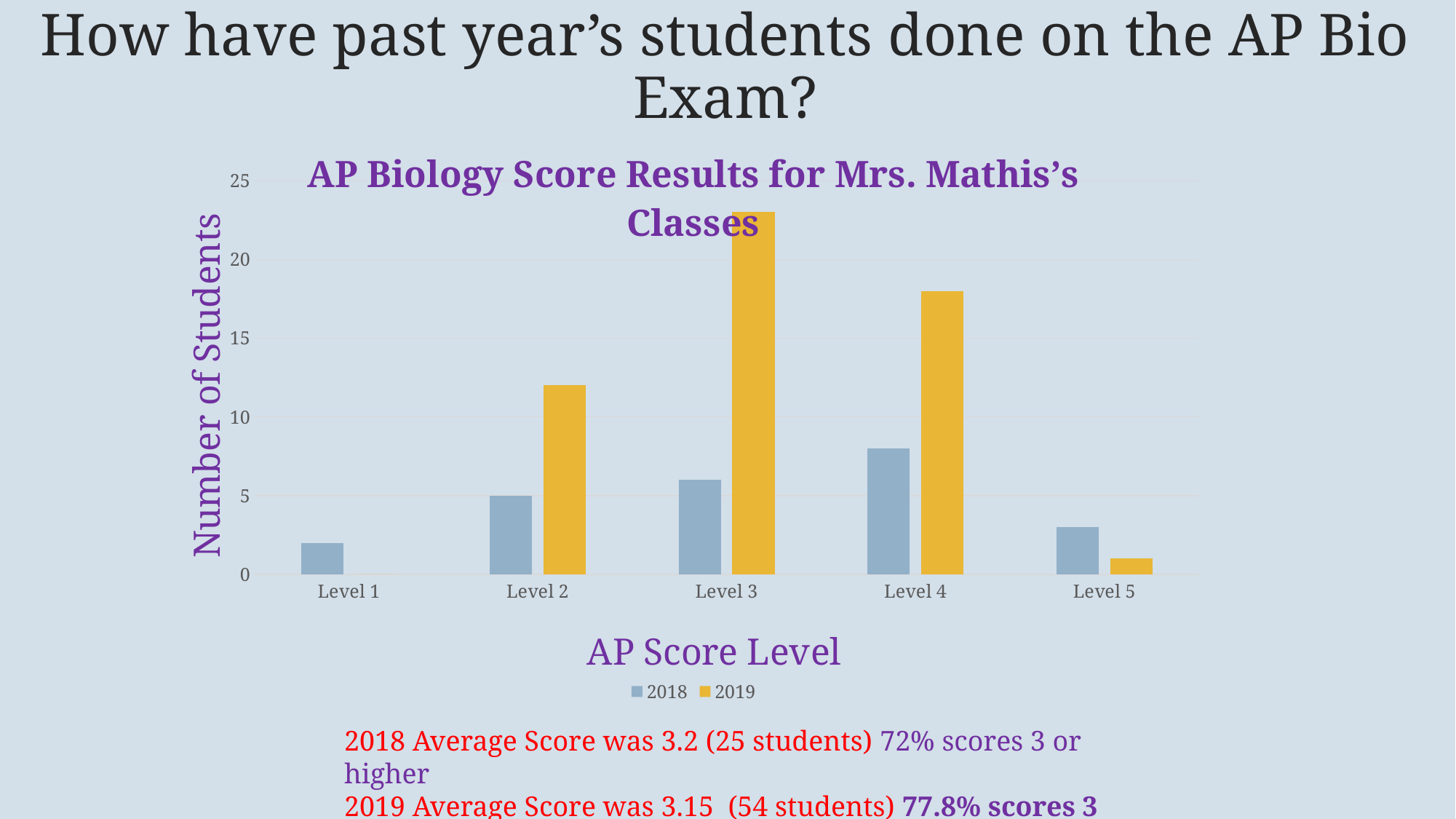
Which AP score level has the highest number of students for 2019? Level 3 What is the label on the vertical axis of the chart? Number of Students At Level 4, which series has the larger number of students, 2018 or 2019? 2019 How many AP score levels are shown on the x axis? 5 How many series does the legend list? 2 Is the 2019 value for Level 5 greater or less than 5? less Which AP score level has the lowest number of students for 2018? Level 1 What kind of chart is shown on the slide? bar chart Is the 2019 value for Level 4 greater or less than 15? greater What is the title of the chart? AP Biology Score Results for Mrs. Mathis's Classes Is the 2018 value for Level 4 greater or less than 10? less